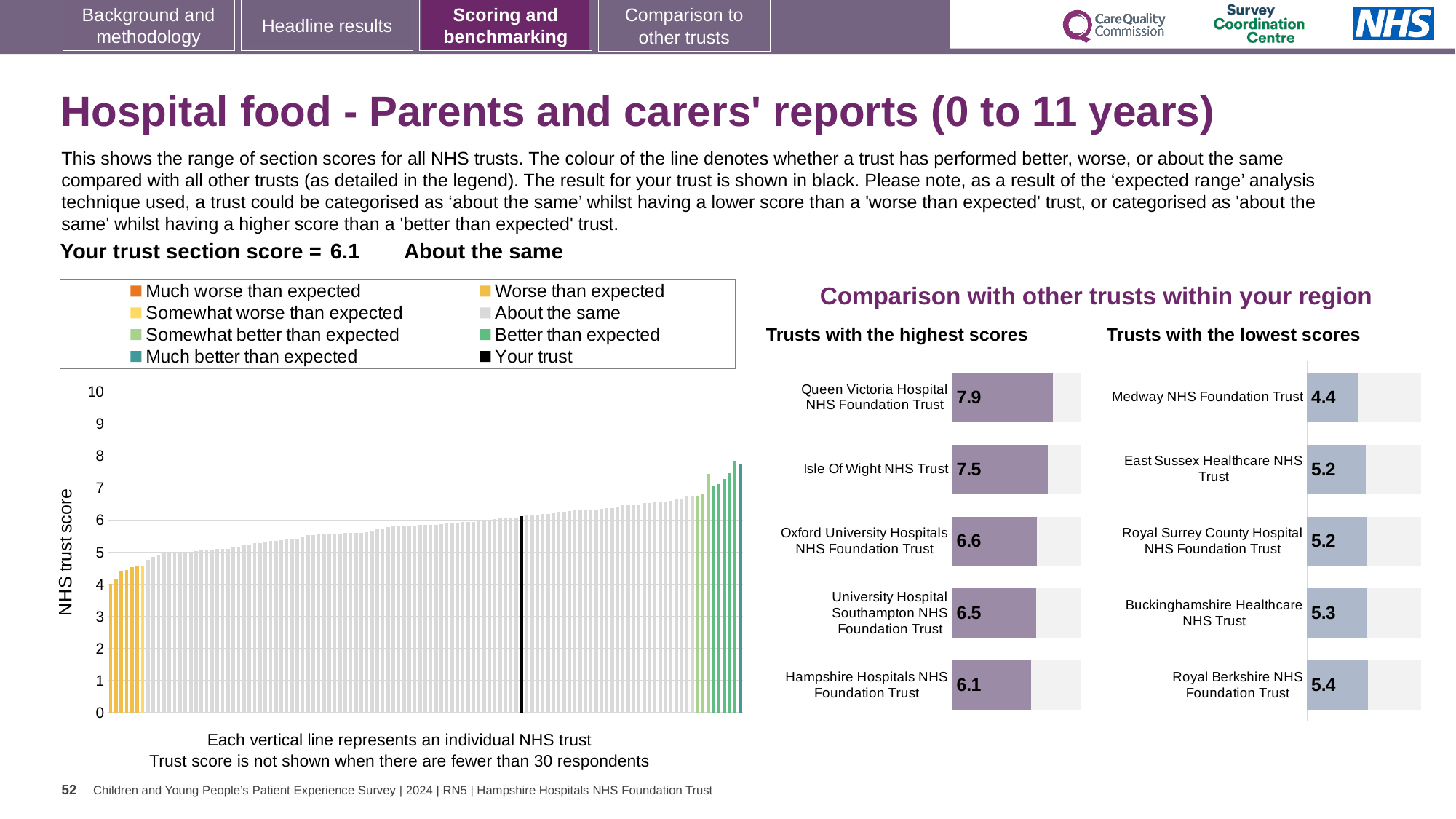
In the main 'NHS trust score' chart, what is the score for your trust (the black line)? 6.1 How many trusts are shown in the 'Trusts with the lowest scores' chart? 5 In the 'Trusts with the lowest scores' chart, which trust has the lowest score? Medway NHS Foundation Trust In the 'Trusts with the lowest scores' chart, what is the score for Medway NHS Foundation Trust? 4.4 In the 'Trusts with the highest scores' chart, what is the score for Queen Victoria Hospital NHS Foundation Trust? 7.9 In the 'Trusts with the highest scores' chart, what is the difference between the scores of Queen Victoria Hospital NHS Foundation Trust and Isle Of Wight NHS Trust? 0.4 In the 'Trusts with the highest scores' chart, which trust has the highest score? Queen Victoria Hospital NHS Foundation Trust In the 'Trusts with the highest scores' chart, which has the higher score: Isle Of Wight NHS Trust or University Hospital Southampton NHS Foundation Trust? Isle Of Wight NHS Trust In the 'Trusts with the lowest scores' chart, what is the score for Royal Berkshire NHS Foundation Trust? 5.4 In the 'Trusts with the highest scores' chart, what is the score for Oxford University Hospitals NHS Foundation Trust? 6.6 In the main 'NHS trust score' chart, do the trust scores rise or fall from left to right? Rise What kind of chart is the main 'NHS trust score' chart? Bar chart